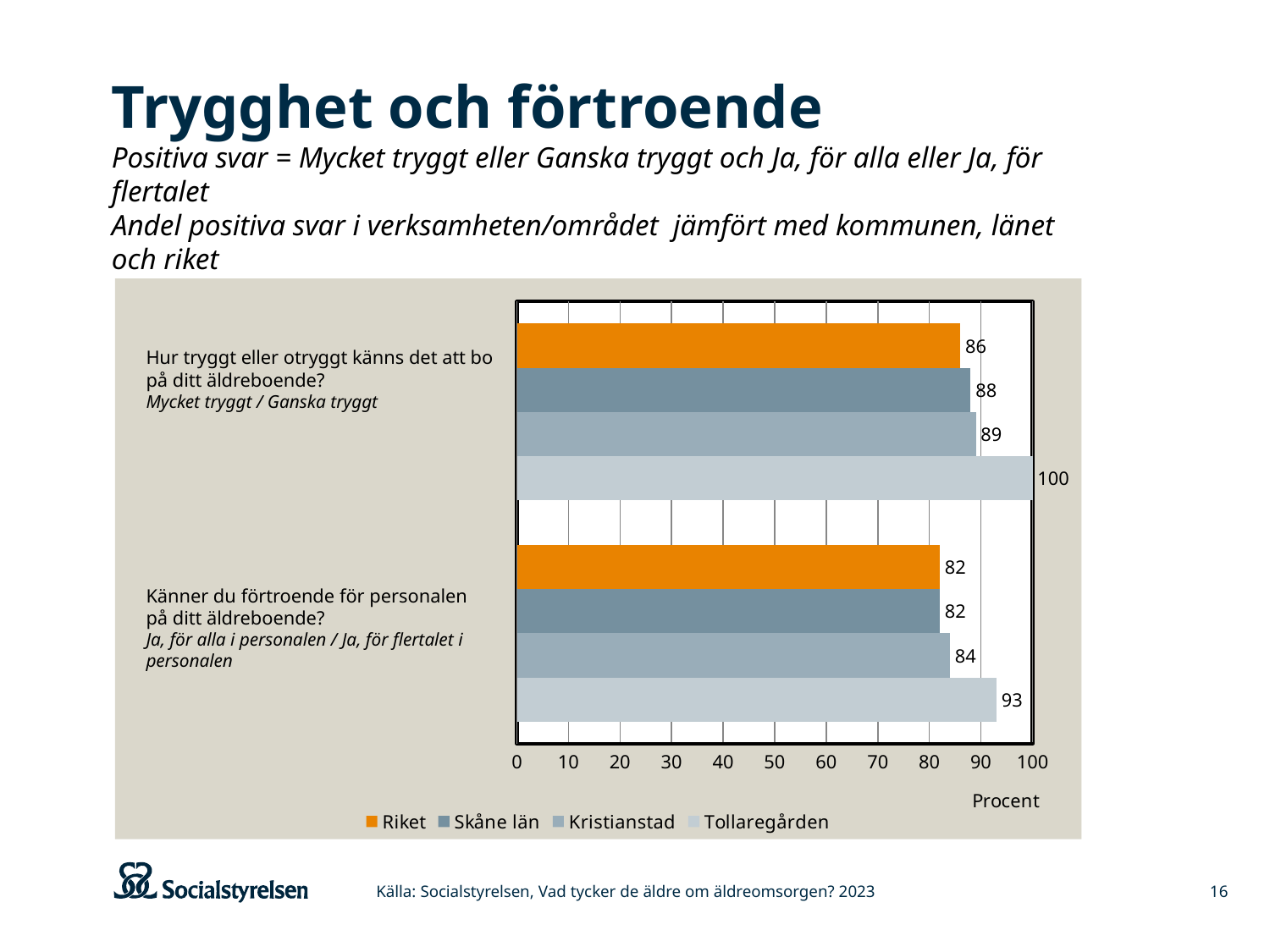
What value does Kristianstad have for the question "Hur tryggt eller otryggt känns det att bo på ditt äldreboende?"? 89 What is the difference between Tollaregården and Kristianstad for the question "Känner du förtroende för personalen på ditt äldreboende?"? 9 Which is larger for Kristianstad: the value for the trygghet question or the value for the förtroende question? The trygghet question (89) Which series has the highest value for the question "Känner du förtroende för personalen på ditt äldreboende?"? Tollaregården What value does Skåne län have for the question "Känner du förtroende för personalen på ditt äldreboende?"? 82 How many series does the legend list? 4 What kind of chart is shown on the slide? Bar chart What value does Tollaregården have for the question "Hur tryggt eller otryggt känns det att bo på ditt äldreboende?"? 100 What is the difference between Tollaregården and Riket for the question "Hur tryggt eller otryggt känns det att bo på ditt äldreboende?"? 14 What value does Riket have for the question "Känner du förtroende för personalen på ditt äldreboende?"? 82 Which series has the lowest value for the question "Hur tryggt eller otryggt känns det att bo på ditt äldreboende?"? Riket Which series is shown in orange in the legend? Riket